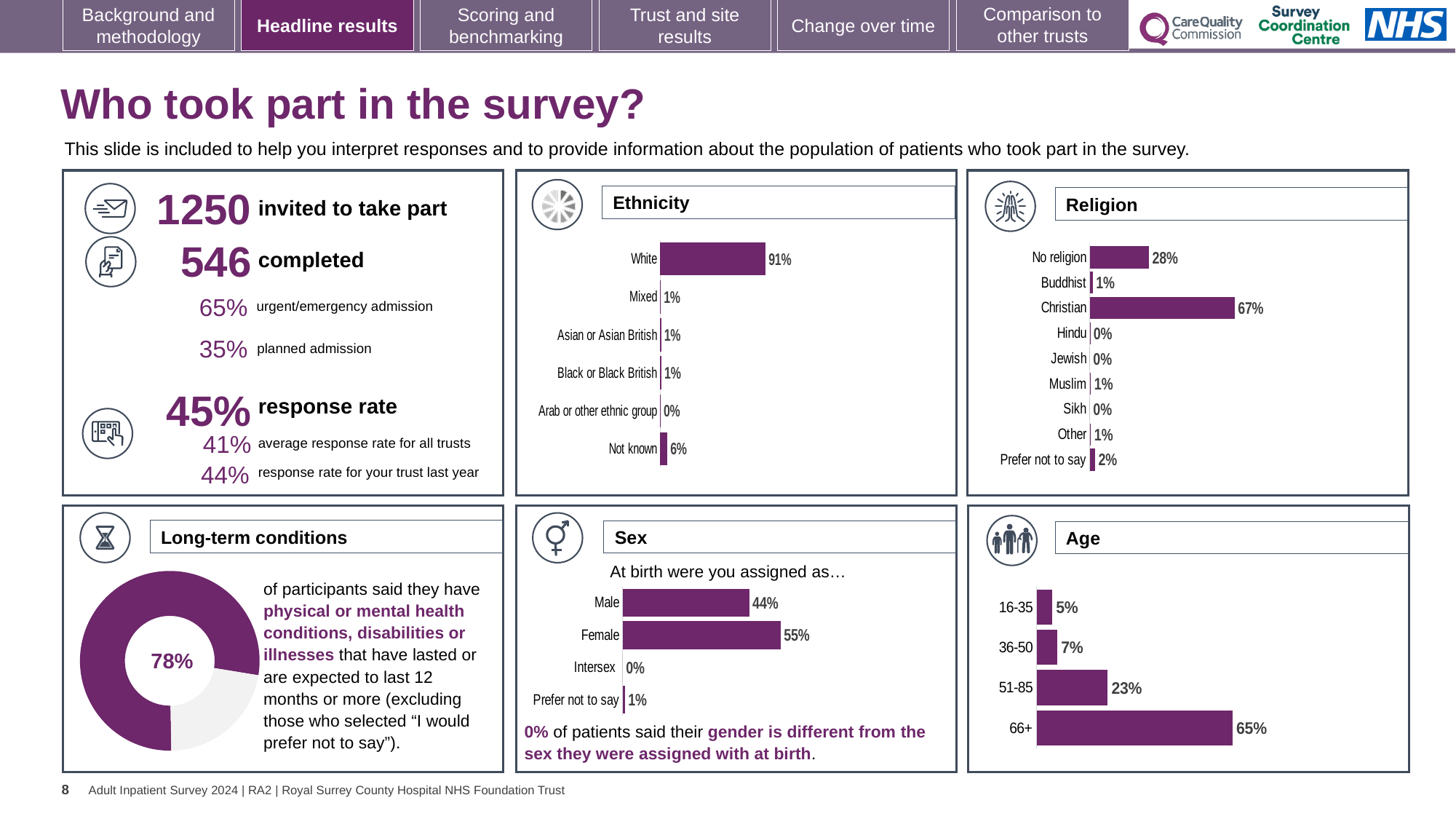
In the Age chart, which age group has the highest percentage? 66+ In the Sex chart, what percentage of respondents were assigned Male at birth? 44% In the Age chart, do the percentages rise or fall as the age groups get older? rise In the Ethnicity chart, what is the difference between the White and Not known percentages? 85% In the Religion chart, what percentage of respondents said they have no religion? 28% In the Religion chart, what is the difference between the Christian and No religion percentages? 39% In the Ethnicity chart, what percentage of respondents were White? 91% In the Religion chart, which religion category has the highest percentage? Christian In the Age chart, what percentage of respondents were aged 51-85? 23% In the Long-term conditions chart, what percentage of participants said they have a long-term condition? 78% In the Ethnicity chart, how many ethnicity categories are shown? 6 In the Sex chart, which is larger, the Male or the Female percentage? Female